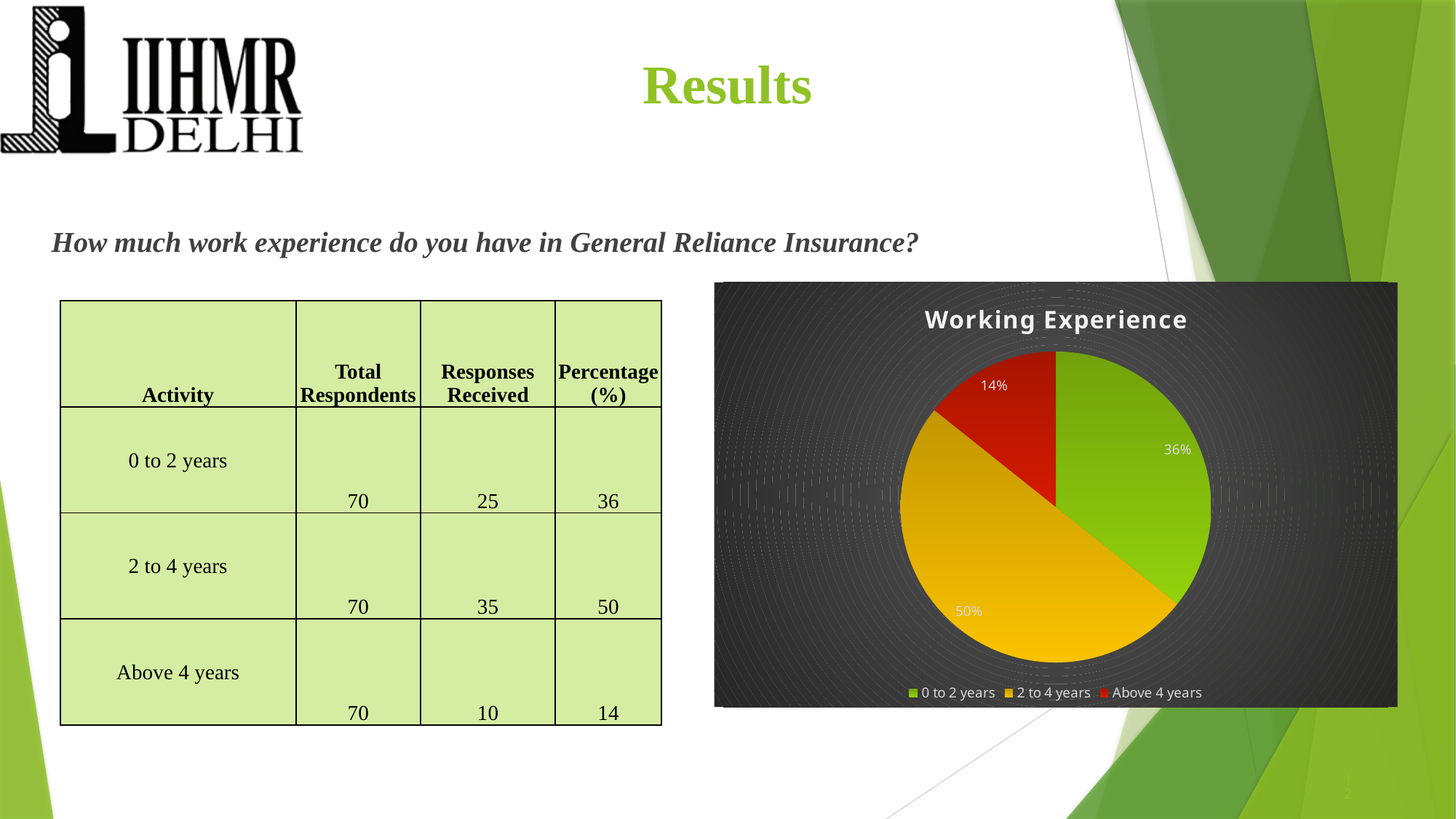
How many slices does the pie chart have? 3 What percentage of the pie does the 'Above 4 years' slice represent? 14% What colour is the 'Above 4 years' slice in the pie chart? red What percentage of the pie does the '2 to 4 years' slice represent? 50% What type of chart is shown on the slide? pie chart What percentage of the pie does the '0 to 2 years' slice represent? 36% What is the title of the chart? Working Experience Which category has the smallest slice of the pie? Above 4 years How many entries does the legend list? 3 Which category has the largest slice of the pie? 2 to 4 years Which slice is larger, '0 to 2 years' or 'Above 4 years'? 0 to 2 years What is the difference in percentage points between the '2 to 4 years' slice and the 'Above 4 years' slice? 36